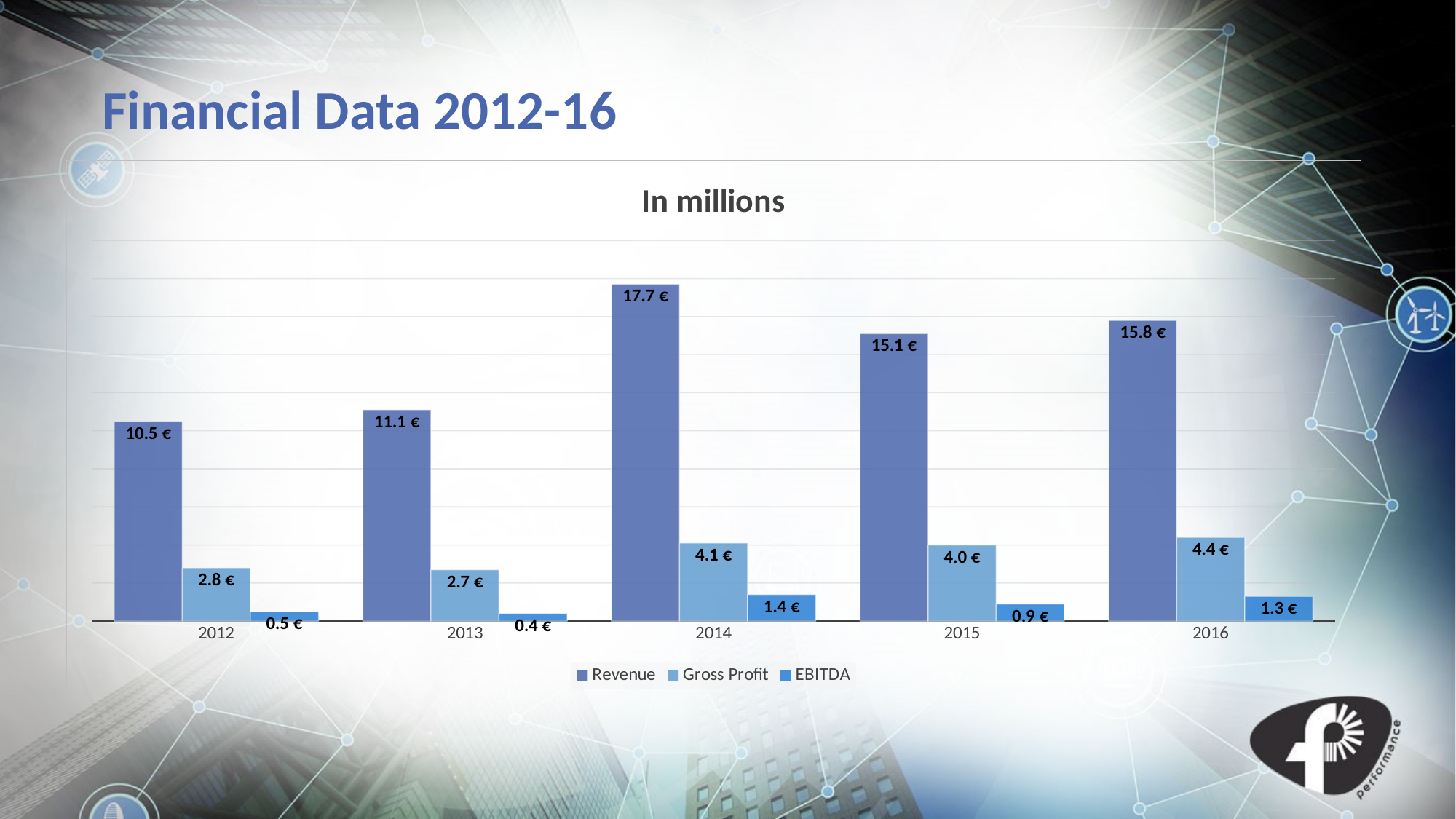
Which year has the highest Revenue? 2014 What kind of chart is shown on the slide? Bar chart What is the difference between Revenue in 2016 and Revenue in 2012? 5.3 € What is the Gross Profit value for 2016? 4.4 € What is the title of the chart? In millions What is the EBITDA value for 2013? 0.4 € How many years are shown on the x axis? 5 Which is larger, Gross Profit in 2014 or Gross Profit in 2015? Gross Profit in 2014 How many series does the legend list? 3 Does Revenue rise or fall from 2012 to 2014? Rise What is the Revenue value for 2014? 17.7 € Which year has the lowest EBITDA? 2013